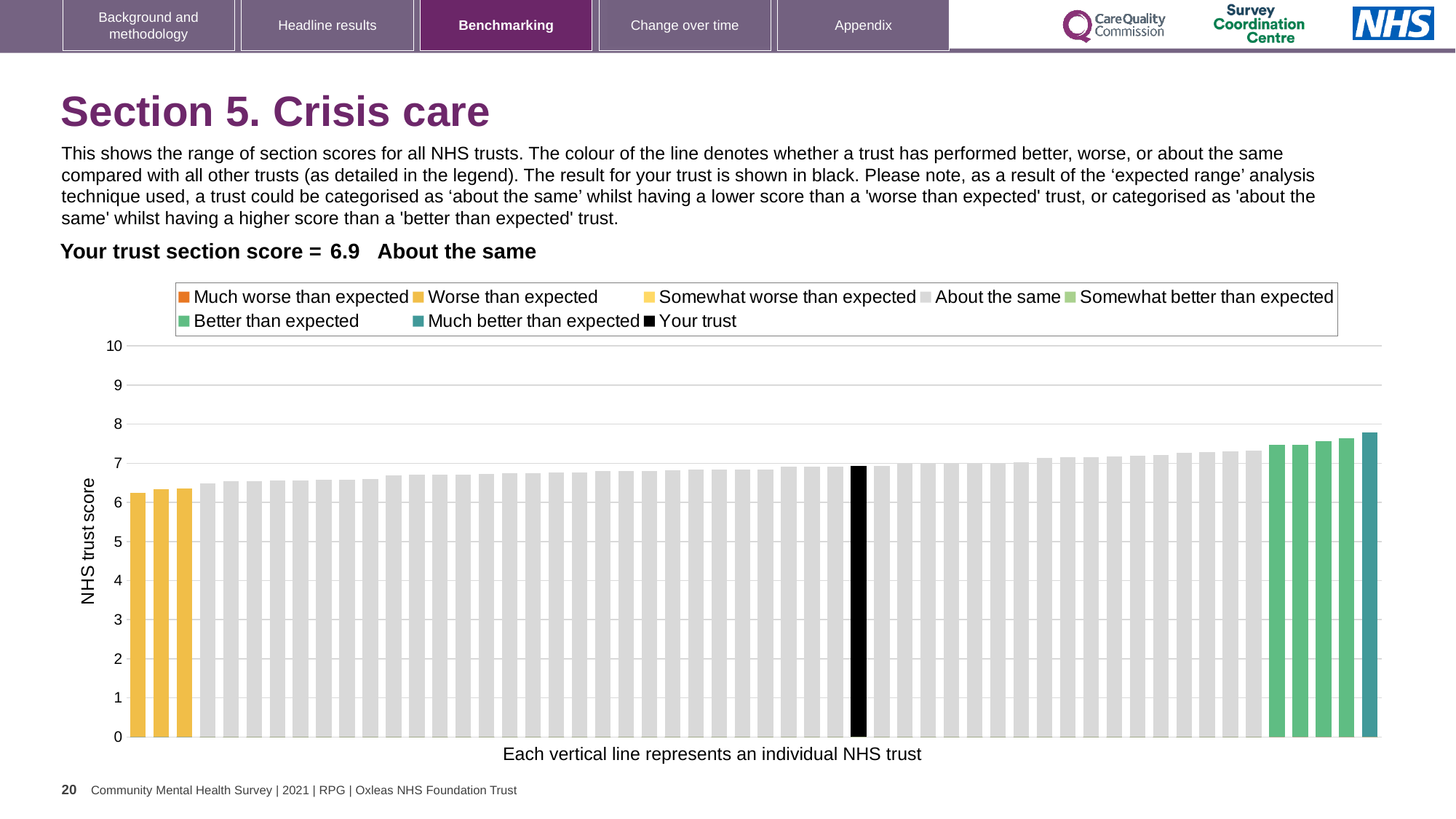
How many bars are coloured as 'Much better than expected'? 1 Is the value of the tallest bar in the chart greater or less than 8? less Is the value of the shortest bar in the chart greater or less than 6? greater What does the text below the horizontal axis say each vertical line represents? an individual NHS trust How many bars are coloured as 'Worse than expected'? 3 What kind of chart is shown on the slide? bar chart What is the label on the vertical axis of the chart? NHS trust score How many entries does the chart legend list? 8 Is the value of the black bar for your trust greater or less than 6? greater Do the bar values rise or fall from left to right along the x axis? rise What is the section score for your trust shown on the slide? 6.9 Which category is your trust placed in for the Crisis care section? About the same